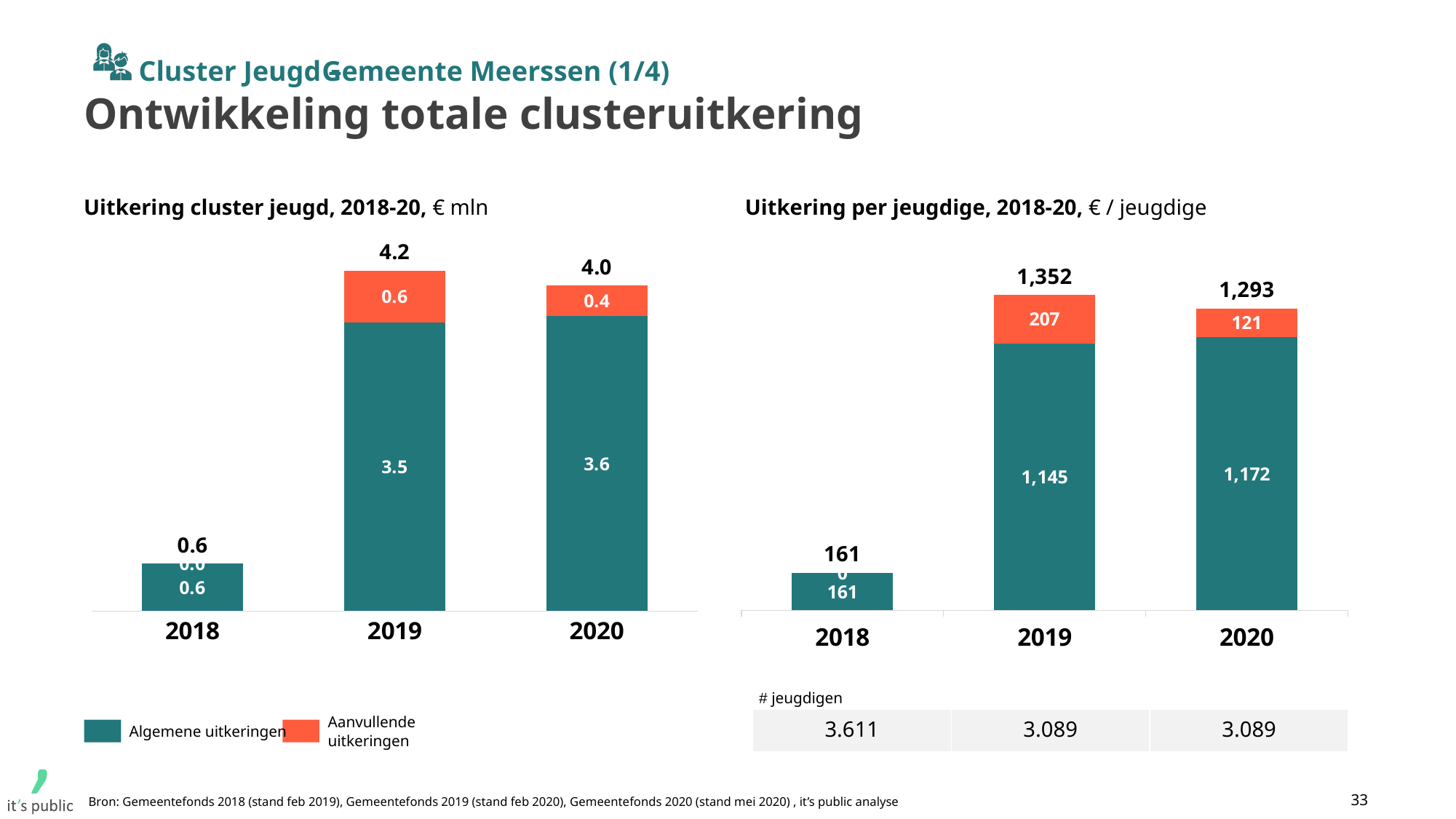
In the chart 'Uitkering per jeugdige, 2018-20', what is the value of Algemene uitkeringen in 2018? 161 What kind of chart is 'Uitkering cluster jeugd, 2018-20'? Stacked bar chart In the chart 'Uitkering per jeugdige, 2018-20', what is the total value for 2020? 1,293 How many series does the legend list on the slide? 2 In the chart 'Uitkering per jeugdige, 2018-20', is the total for 2019 or 2020 larger? 2019 In the chart 'Uitkering cluster jeugd, 2018-20', what is the value of Algemene uitkeringen in 2020? 3.6 In the chart 'Uitkering per jeugdige, 2018-20', what is the value of Aanvullende uitkeringen in 2019? 207 In the chart 'Uitkering cluster jeugd, 2018-20', which year has the lowest total? 2018 In the chart 'Uitkering cluster jeugd, 2018-20', which year has the highest total? 2019 In the chart 'Uitkering cluster jeugd, 2018-20', what is the total value for 2019? 4.2 In the chart 'Uitkering cluster jeugd, 2018-20', what is the difference between the totals for 2019 and 2020? 0.2 In the chart 'Uitkering cluster jeugd, 2018-20', what is the value of Aanvullende uitkeringen in 2019? 0.6